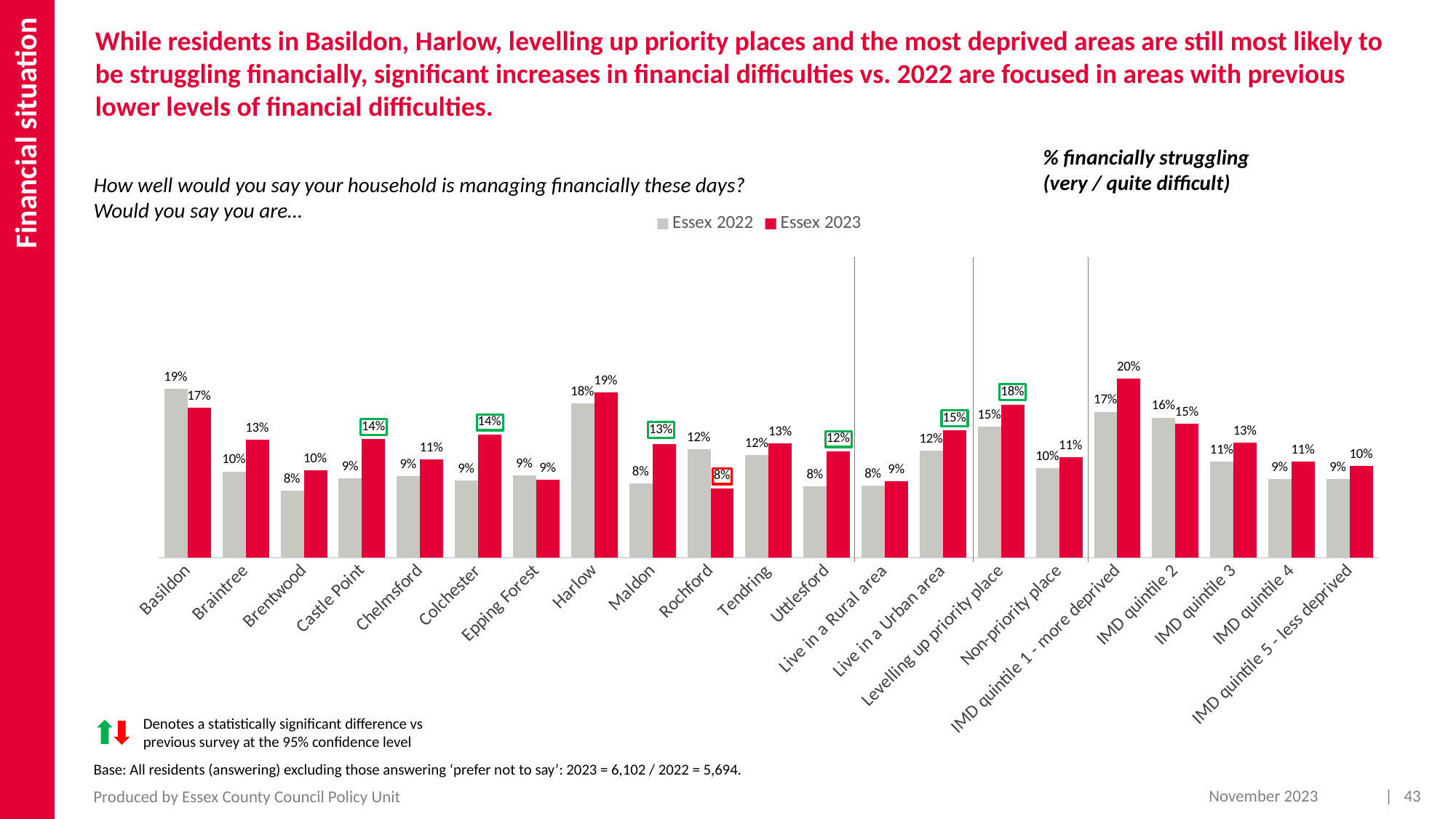
What colour are the Essex 2023 bars? Red What kind of chart is shown on the slide? Bar chart How many categories are shown on the x axis of the chart? 21 Which category has the highest Essex 2022 value? Basildon Which is larger for Basildon, the Essex 2022 value or the Essex 2023 value? Essex 2022 Which category has the lowest Essex 2023 value? Rochford What is the Essex 2023 value for Castle Point? 14% What is the Essex 2022 value for Rochford? 12% What is the Essex 2023 value for Levelling up priority place? 18% How many series does the legend list? 2 Which category has the highest Essex 2023 value? IMD quintile 1 - more deprived What is the difference between the Essex 2023 and Essex 2022 values for Maldon? 5%